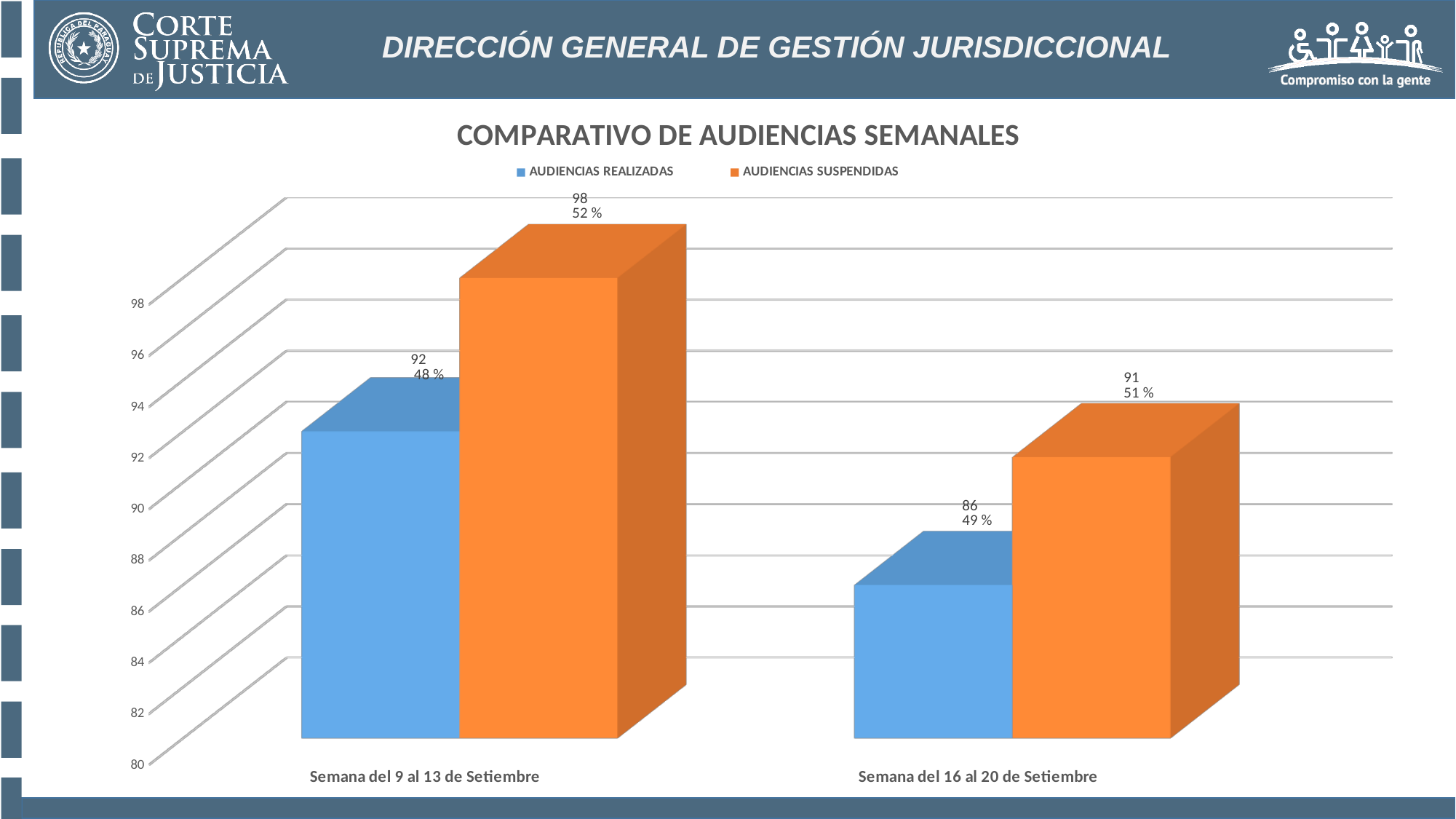
What is the difference in AUDIENCIAS REALIZADAS between Semana del 9 al 13 de Setiembre and Semana del 16 al 20 de Setiembre? 6 What is the value of AUDIENCIAS REALIZADAS for Semana del 9 al 13 de Setiembre? 92 What is the difference between AUDIENCIAS SUSPENDIDAS and AUDIENCIAS REALIZADAS in Semana del 9 al 13 de Setiembre? 6 What is the value of AUDIENCIAS SUSPENDIDAS for Semana del 16 al 20 de Setiembre? 91 What percentage is shown for AUDIENCIAS SUSPENDIDAS in Semana del 9 al 13 de Setiembre? 52 % How many series does the legend list? 2 How many weeks (categories) are shown on the x axis? 2 Which is larger in Semana del 16 al 20 de Setiembre: AUDIENCIAS REALIZADAS or AUDIENCIAS SUSPENDIDAS? AUDIENCIAS SUSPENDIDAS What type of chart is shown on the slide? Bar chart What percentage is shown for AUDIENCIAS REALIZADAS in Semana del 16 al 20 de Setiembre? 49 % Which week has the lowest value for AUDIENCIAS REALIZADAS? Semana del 16 al 20 de Setiembre Which week has the highest value for AUDIENCIAS SUSPENDIDAS? Semana del 9 al 13 de Setiembre